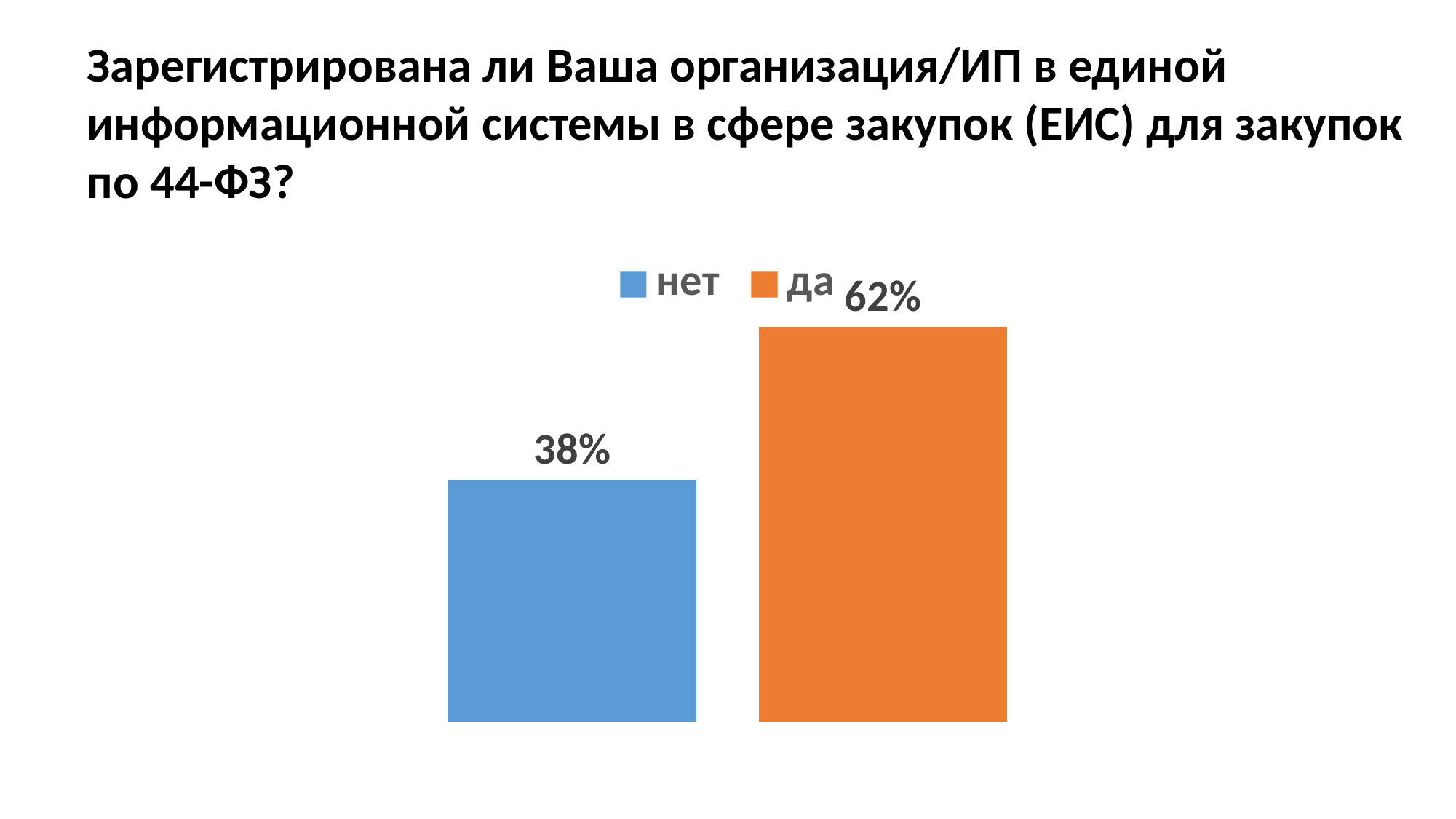
What colour is the bar for "нет"? blue What is the total of the two values shown in the chart? 100% What colour is the bar for "да"? orange How many bars are shown in the chart? 2 How many entries does the legend list? 2 What is the difference between the values for "да" and "нет"? 24% Which category has the highest value? да Which category has the lowest value? нет What is the value for "нет"? 38% What is the value for "да"? 62% What kind of chart is shown on the slide? bar chart Which is larger, the value for "да" or the value for "нет"? да